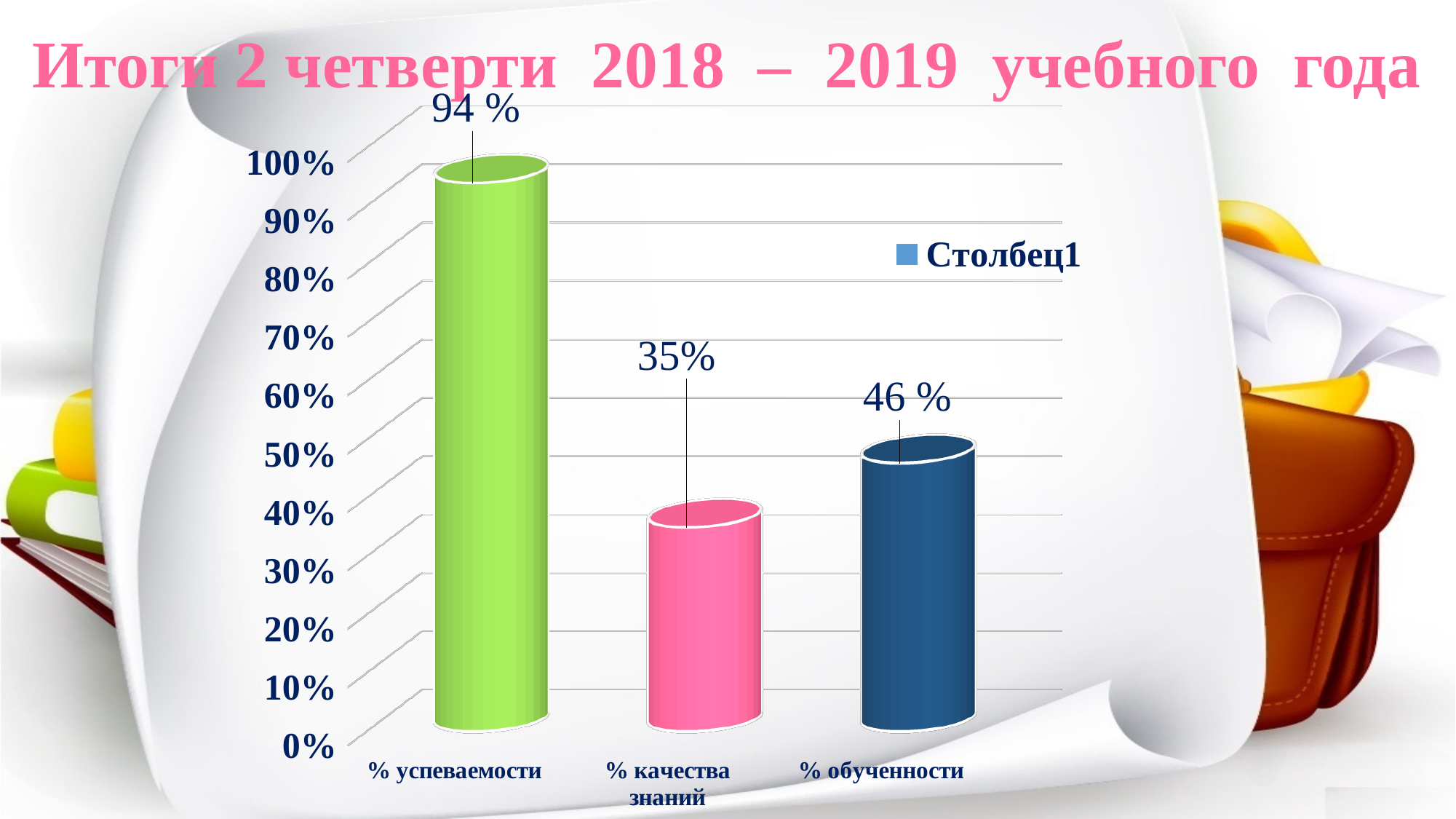
Which is larger, the value for % обученности or the value for % качества знаний? % обученности What is the value for % успеваемости? 94 % How many series does the legend list? 1 What is the difference between the values for % обученности and % качества знаний? 11% What is the value for % качества знаний? 35% What is the difference between the values for % успеваемости and % качества знаний? 59% How many categories are shown on the chart? 3 Which category has the highest value? % успеваемости What is the value for % обученности? 46 % What kind of chart is shown on the slide? bar chart What is the title of the slide? Итоги 2 четверти 2018 – 2019 учебного года Which category has the lowest value? % качества знаний